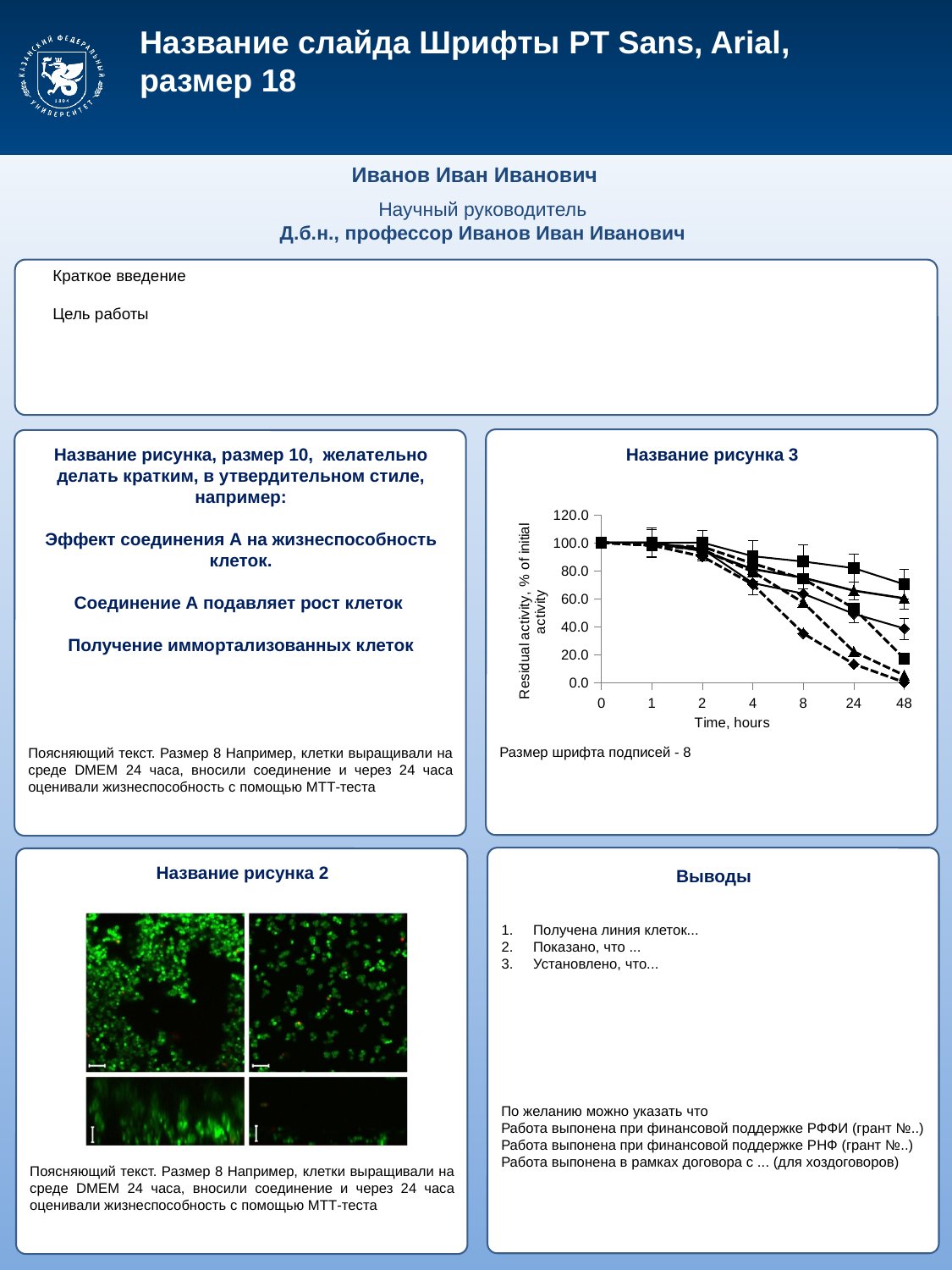
In the chart "Название рисунка 3", what is the title of the y axis? Residual activity, % of initial activity What kind of chart is shown under "Название рисунка 3"? line chart How many lines are plotted in the chart "Название рисунка 3"? 6 In the chart "Название рисунка 3", what is the residual activity value of all lines at 0 hours? 100.0 In the chart "Название рисунка 3", is the lowest value at 8 hours greater or less than 60.0? less In the chart "Название рисунка 3", what is the title of the x axis? Time, hours In the chart "Название рисунка 3", at which time point do all lines reach their lowest values? 48 In the chart "Название рисунка 3", is the highest value at 48 hours greater or less than 60.0? greater In the chart "Название рисунка 3", is the lowest value at 48 hours greater or less than 20.0? less How many time points are marked on the x axis of the chart "Название рисунка 3"? 7 What is the largest value shown on the y axis of the chart "Название рисунка 3"? 120.0 In the chart "Название рисунка 3", do the values rise or fall as time increases? fall